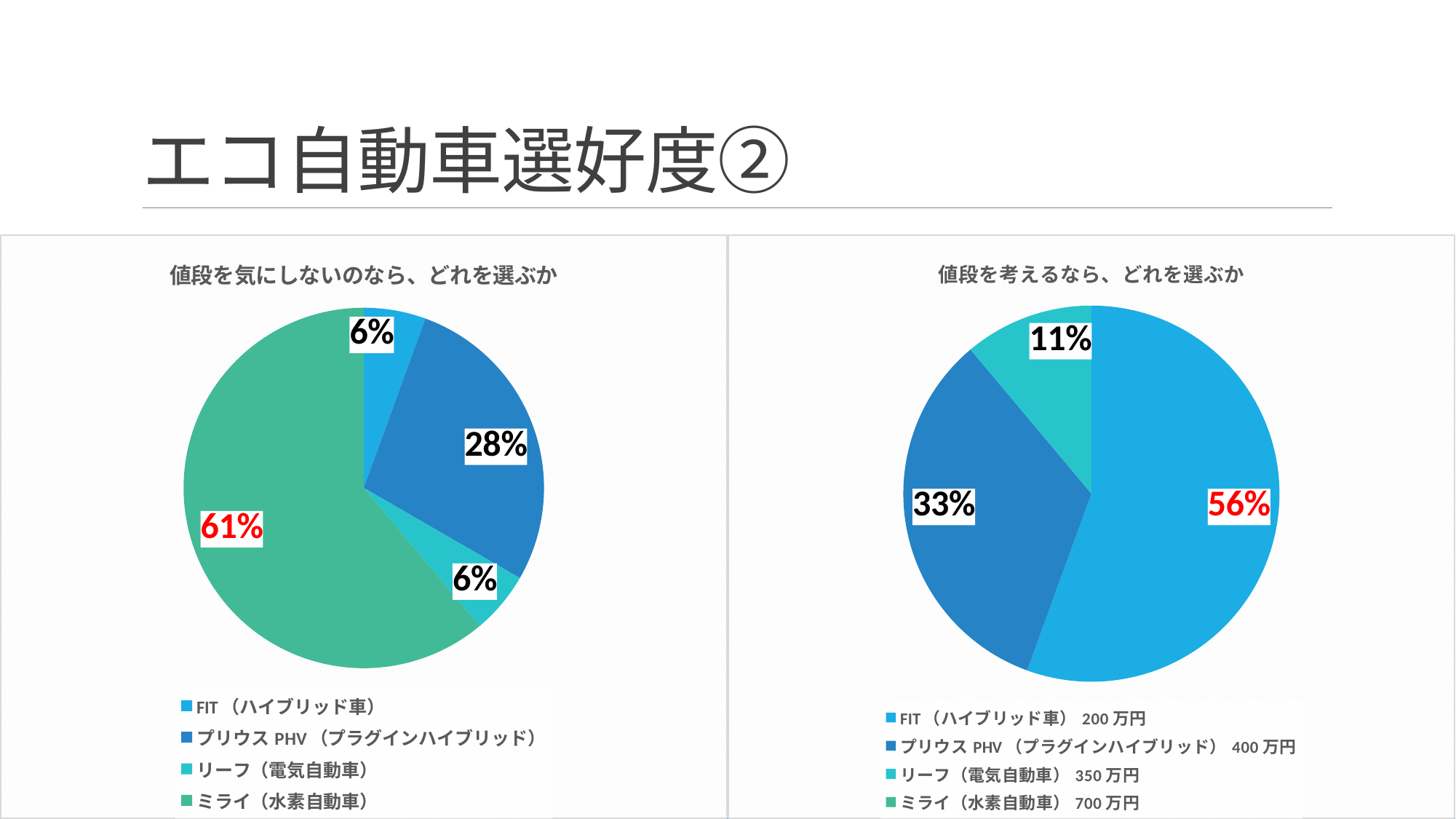
Which chart gives プリウス PHV（プラグインハイブリッド） a larger share, the left chart or the right chart? the right chart In the right chart (値段を考えるなら、どれを選ぶか), what share does リーフ（電気自動車） have? 11% How many entries does the legend of the left chart (値段を気にしないのなら、どれを選ぶか) list? 4 In the left chart (値段を気にしないのなら、どれを選ぶか), what share does ミライ（水素自動車） have? 61% What type of chart is used on this slide? pie chart In the right chart (値段を考えるなら、どれを選ぶか), what is the difference between the shares of FIT（ハイブリッド車） and プリウス PHV（プラグインハイブリッド）? 23% In the left chart (値段を気にしないのなら、どれを選ぶか), what share does プリウス PHV（プラグインハイブリッド） have? 28% In the right chart (値段を考えるなら、どれを選ぶか), what share does FIT（ハイブリッド車） have? 56% In the left chart (値段を気にしないのなら、どれを選ぶか), which category has the largest share? ミライ（水素自動車） In the left chart (値段を気にしないのなら、どれを選ぶか), what is the difference between the shares of ミライ（水素自動車） and プリウス PHV（プラグインハイブリッド）? 33% In the right chart (値段を考えるなら、どれを選ぶか), which category has the largest share? FIT（ハイブリッド車） In the right chart (値段を考えるなら、どれを選ぶか), which labelled slice is the smallest? リーフ（電気自動車）